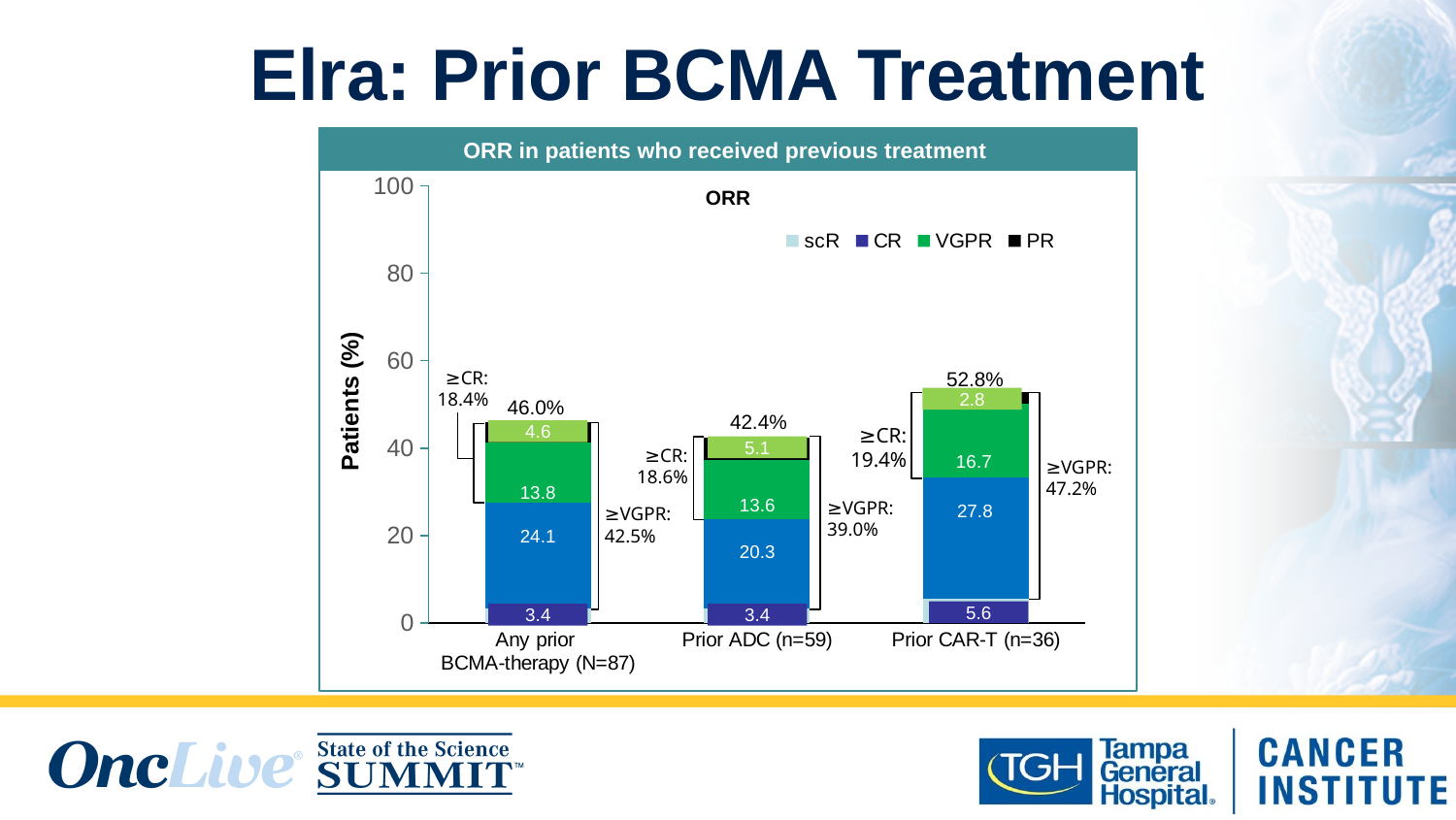
What is the overall response rate shown above the bar for Prior CAR-T (n=36)? 52.8% What is the ≥VGPR rate annotated for Prior ADC (n=59)? 39.0% Which category has the lowest overall response rate? Prior ADC (n=59) What is the overall response rate shown above the bar for Prior ADC (n=59)? 42.4% Which category has the highest overall response rate? Prior CAR-T (n=36) What is the ≥CR rate annotated for Prior CAR-T (n=36)? 19.4% Is the overall response rate for Prior CAR-T (n=36) greater or less than 60? less What is the difference between the overall response rates for Prior CAR-T (n=36) and Any prior BCMA-therapy (N=87)? 6.8 percentage points How many series does the legend list? 4 What is the overall response rate shown above the bar for Any prior BCMA-therapy (N=87)? 46.0% What kind of chart is shown on the slide? Stacked bar chart How many categories are shown on the x axis? 3